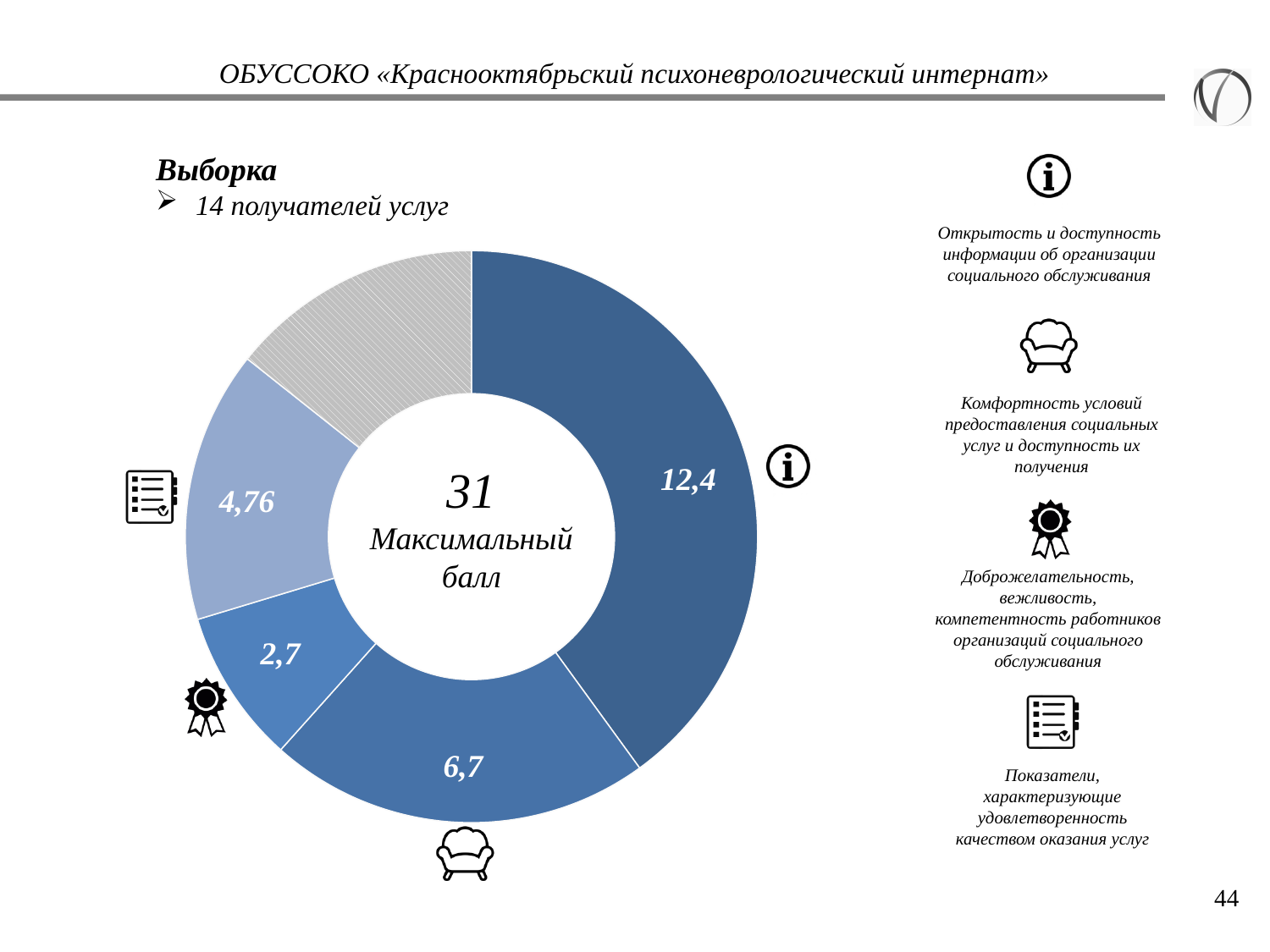
What value is shown for the segment marked with the information icon (Открытость и доступность информации об организации социального обслуживания)? 12,4 Which labelled segment of the donut chart has the highest value? Открытость и доступность информации (12,4) Which labelled segment of the donut chart has the lowest value? Доброжелательность, вежливость, компетентность работников (2,7) What kind of chart is shown on the slide? donut (pie) chart What value is shown for the segment marked with the award/medal icon (Доброжелательность, вежливость, компетентность работников)? 2,7 What is the difference between the information-icon segment (12,4) and the armchair-icon segment (6,7)? 5,7 Which is larger: the armchair-icon segment or the checklist-icon segment? the armchair-icon segment (6,7) What text is shown in the centre of the donut chart? 31 Максимальный балл What value is shown for the segment marked with the checklist icon (Показатели, характеризующие удовлетворенность качеством оказания услуг)? 4,76 What value is shown for the segment marked with the armchair icon (Комфортность условий предоставления социальных услуг)? 6,7 What is the difference between the checklist-icon segment (4,76) and the award-icon segment (2,7)? 2,06 How many segments of the donut chart have a printed value? 4